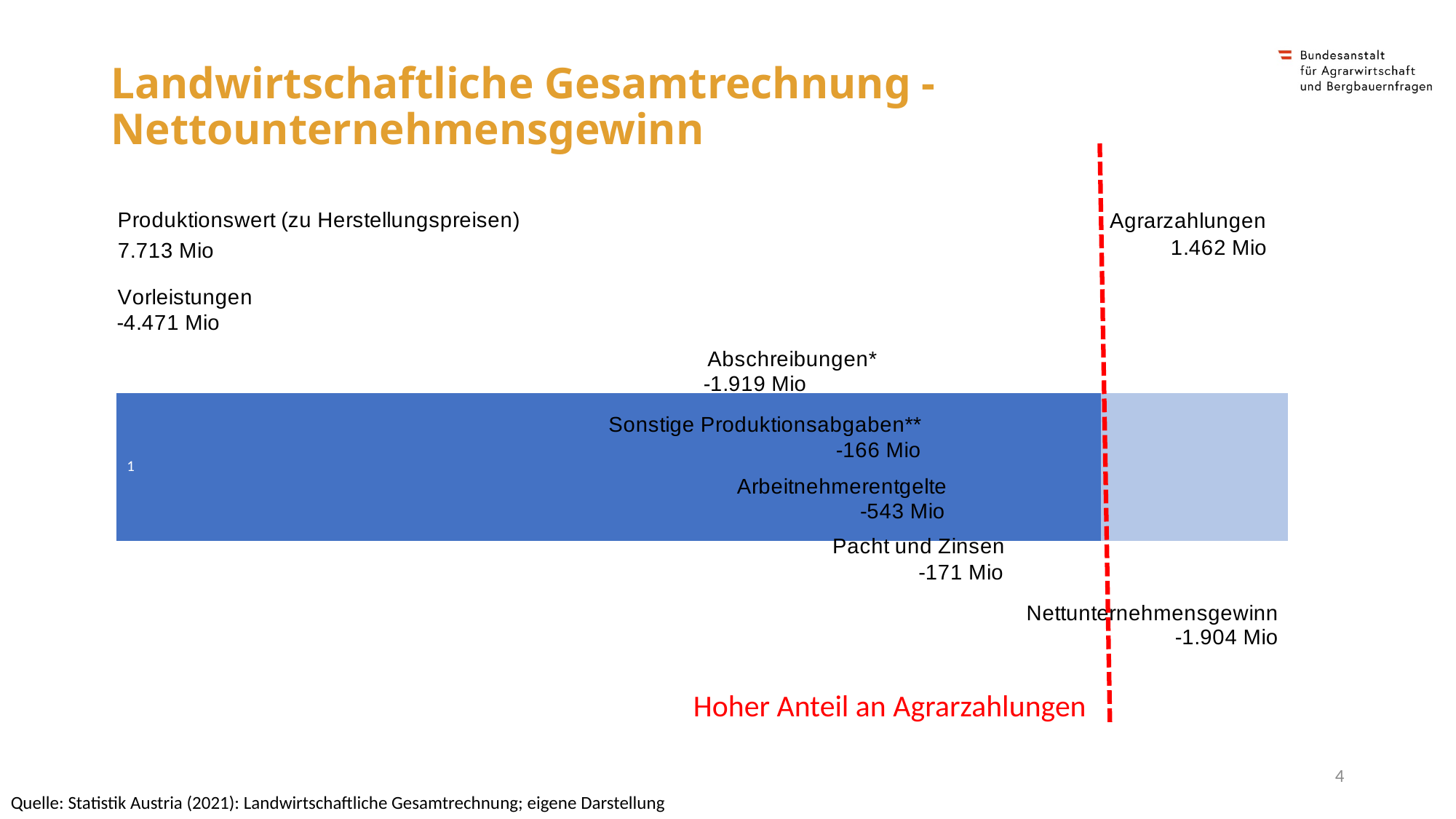
What value is given for Pacht und Zinsen? -171 Mio What value is given for Produktionswert (zu Herstellungspreisen)? 7.713 Mio Which is larger in absolute terms, Arbeitnehmerentgelte or Pacht und Zinsen? Arbeitnehmerentgelte What value is given for Agrarzahlungen? 1.462 Mio What value is given for Abschreibungen*? -1.919 Mio What value is given for Sonstige Produktionsabgaben**? -166 Mio What value is given for Nettunternehmensgewinn? -1.904 Mio What value is given for Vorleistungen? -4.471 Mio What does the red annotation text at the bottom of the chart say? Hoher Anteil an Agrarzahlungen What kind of chart is shown on the slide? bar chart What value is given for Arbeitnehmerentgelte? -543 Mio How many coloured segments does the horizontal bar have? 2